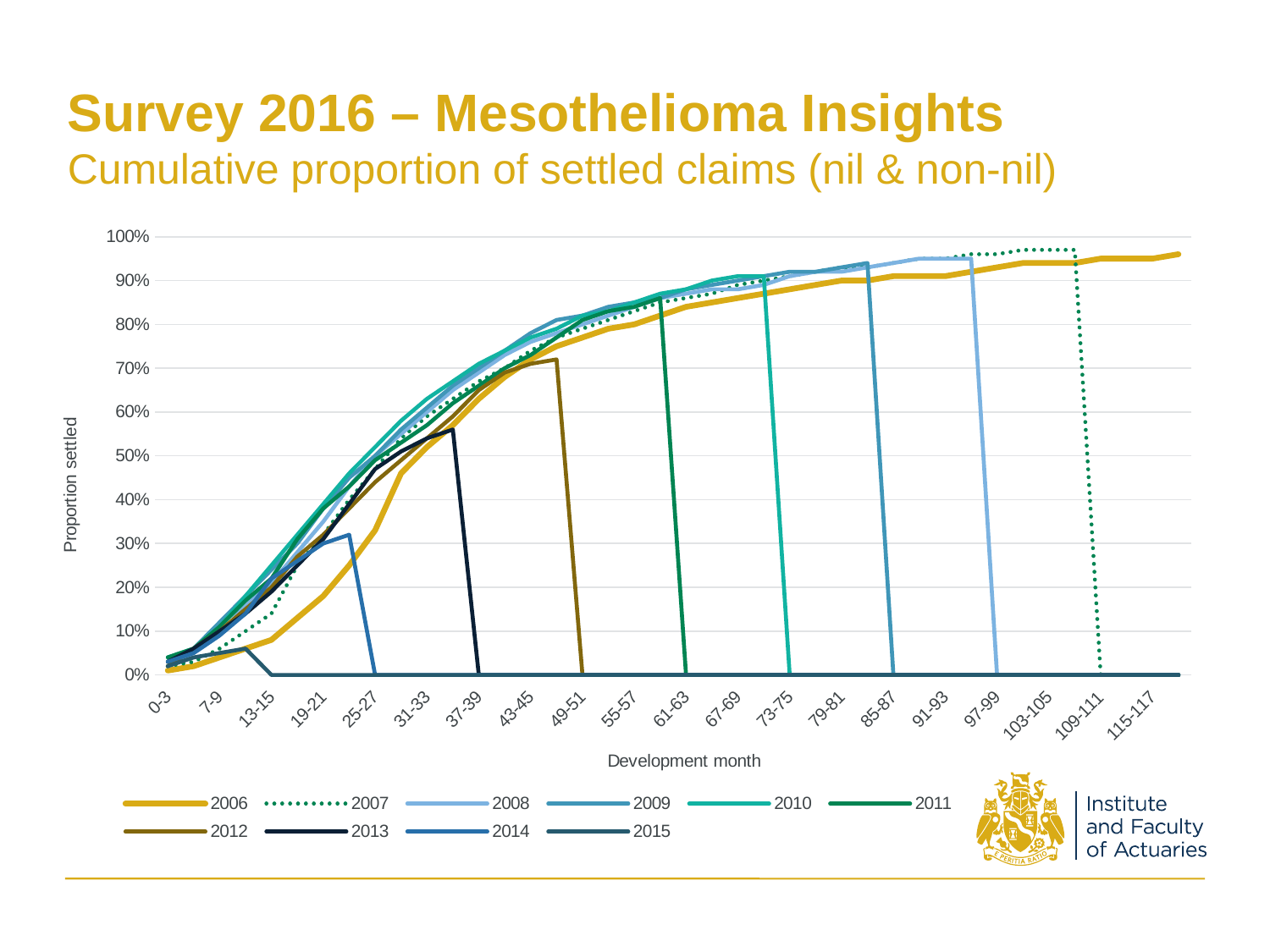
Is the peak value reached by the 2014 series greater or less than 40%? less Does the 2006 series rise or fall as development month increases? rise At development month 13-15, which series has the larger value, 2006 or 2010? 2010 Is the peak value reached by the 2013 series greater or less than 50%? greater What is the label of the vertical axis? Proportion settled What kind of chart is shown on the slide? line chart Is the peak value reached by the 2012 series greater or less than 60%? greater Which series is drawn with a dotted line? 2007 How many series does the legend list? 10 At development month 25-27, which series has the larger value, 2006 or 2013? 2013